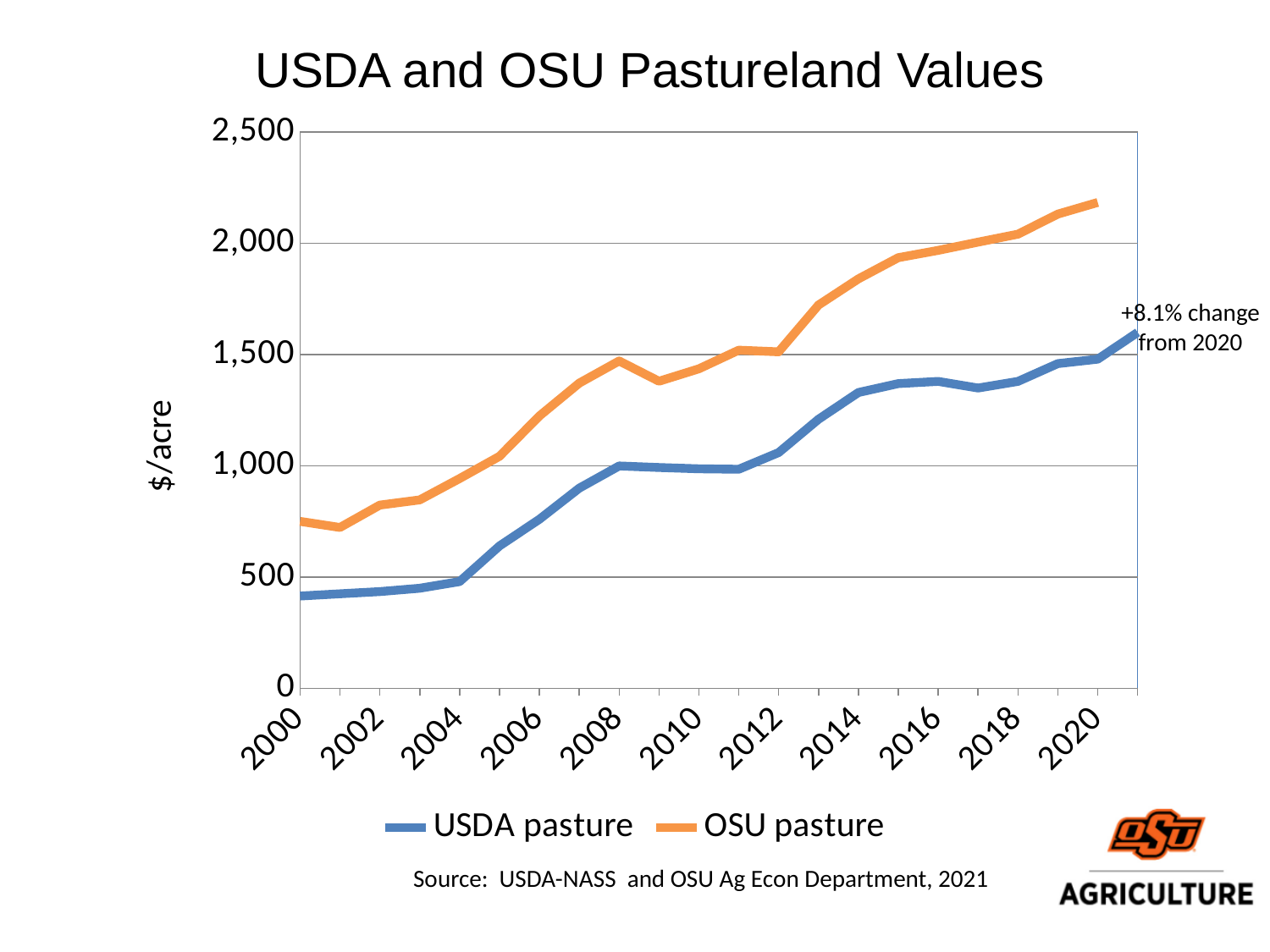
Is the value for OSU pasture in 2020 greater or less than 2,000? greater Is the value for USDA pasture in 2014 greater or less than 1,000? greater What kind of chart is shown on the slide? line chart How many series does the legend list? 2 In 2010, which series has the higher value, USDA pasture or OSU pasture? OSU pasture What is the label on the vertical axis? $/acre Is the value for USDA pasture in 2016 greater or less than 1,500? less Which series is plotted in orange? OSU pasture What is the title of the chart? USDA and OSU Pastureland Values Overall, do the USDA pasture values rise or fall from 2000 to the end of the series? rise